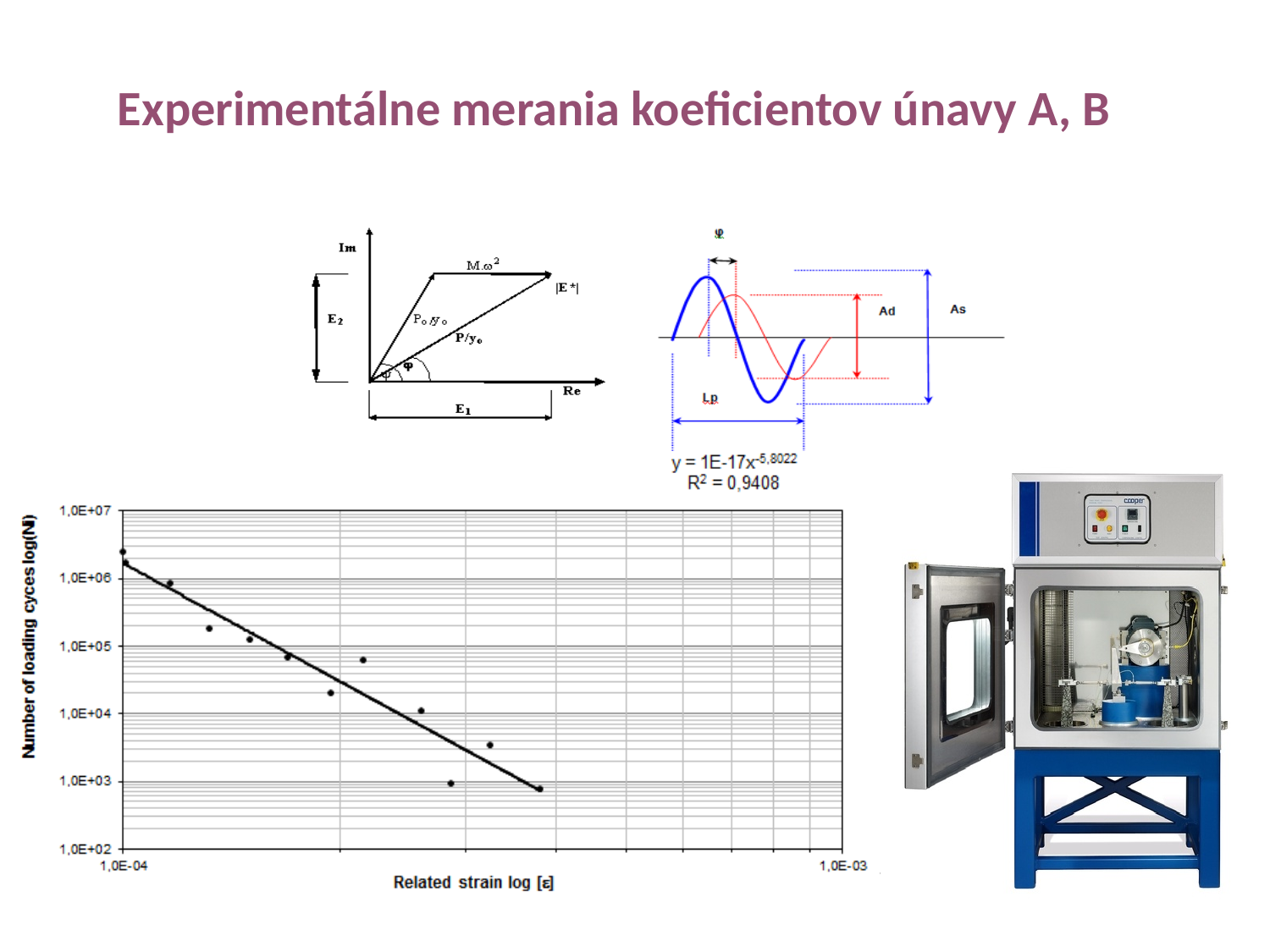
What is the smallest value shown on the x axis of the scatter chart? 1,0E-04 What is the lowest value shown on the y axis of the scatter chart? 1,0E+02 In the scatter chart, are the data points at low related strain higher or lower in number of loading cycles than those at high related strain? higher What is the highest value shown on the y axis of the scatter chart? 1,0E+07 What is the trend line equation printed above the scatter chart? y = 1E-17x^-5,8022 What R² value is printed for the trend line of the scatter chart? 0,9408 What kind of chart is the plot of number of loading cycles against related strain? scatter chart In the scatter chart, do the number of loading cycles rise or fall as the related strain increases? fall Is the number of loading cycles for the highest data point in the scatter chart greater or less than 1,0E+06? greater What is the label of the x axis of the scatter chart? Related strain log [ε] What is the label of the y axis of the scatter chart? Number of loading cyces log(Ni) Is the number of loading cycles for the data point at the largest related strain in the scatter chart greater or less than 1,0E+04? less